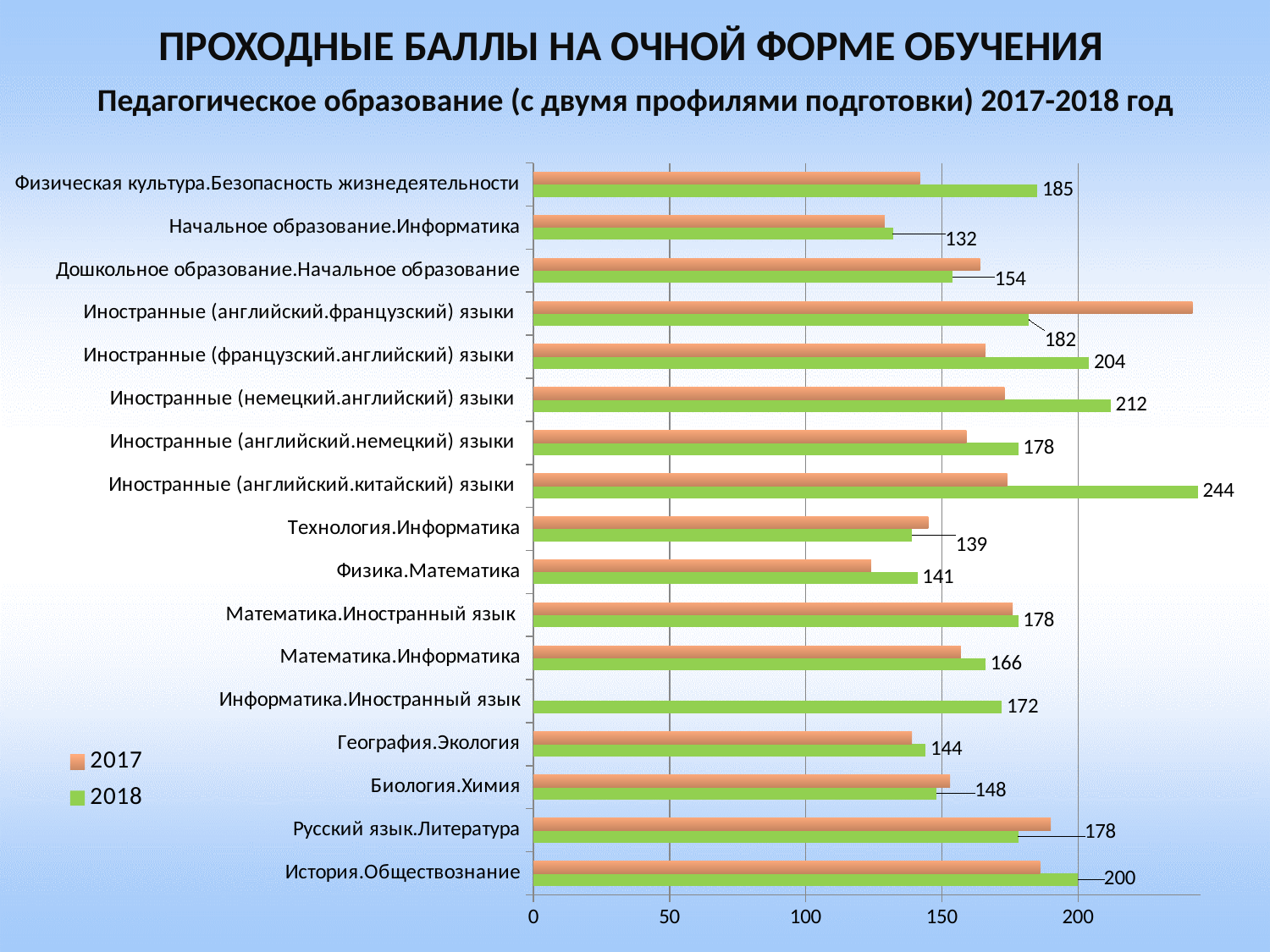
Which category has the highest 2018 value? Иностранные (английский.китайский) языки What kind of chart is shown on the slide? bar chart Is the 2017 value for Физика.Математика greater or less than 150? less How many categories are shown on the chart? 17 What is the difference between the 2018 values for Иностранные (английский.китайский) языки and Начальное образование.Информатика? 112 What is the 2018 value for История.Обществознание? 200 Is the 2017 value for Иностранные (английский.французский) языки greater or less than 200? greater What is the 2018 value for Иностранные (английский.китайский) языки? 244 What is the 2018 value for Начальное образование.Информатика? 132 Which has the larger 2018 value: Иностранные (немецкий.английский) языки or Иностранные (французский.английский) языки? Иностранные (немецкий.английский) языки Which category has the lowest 2018 value? Начальное образование.Информатика How many series does the legend list? 2